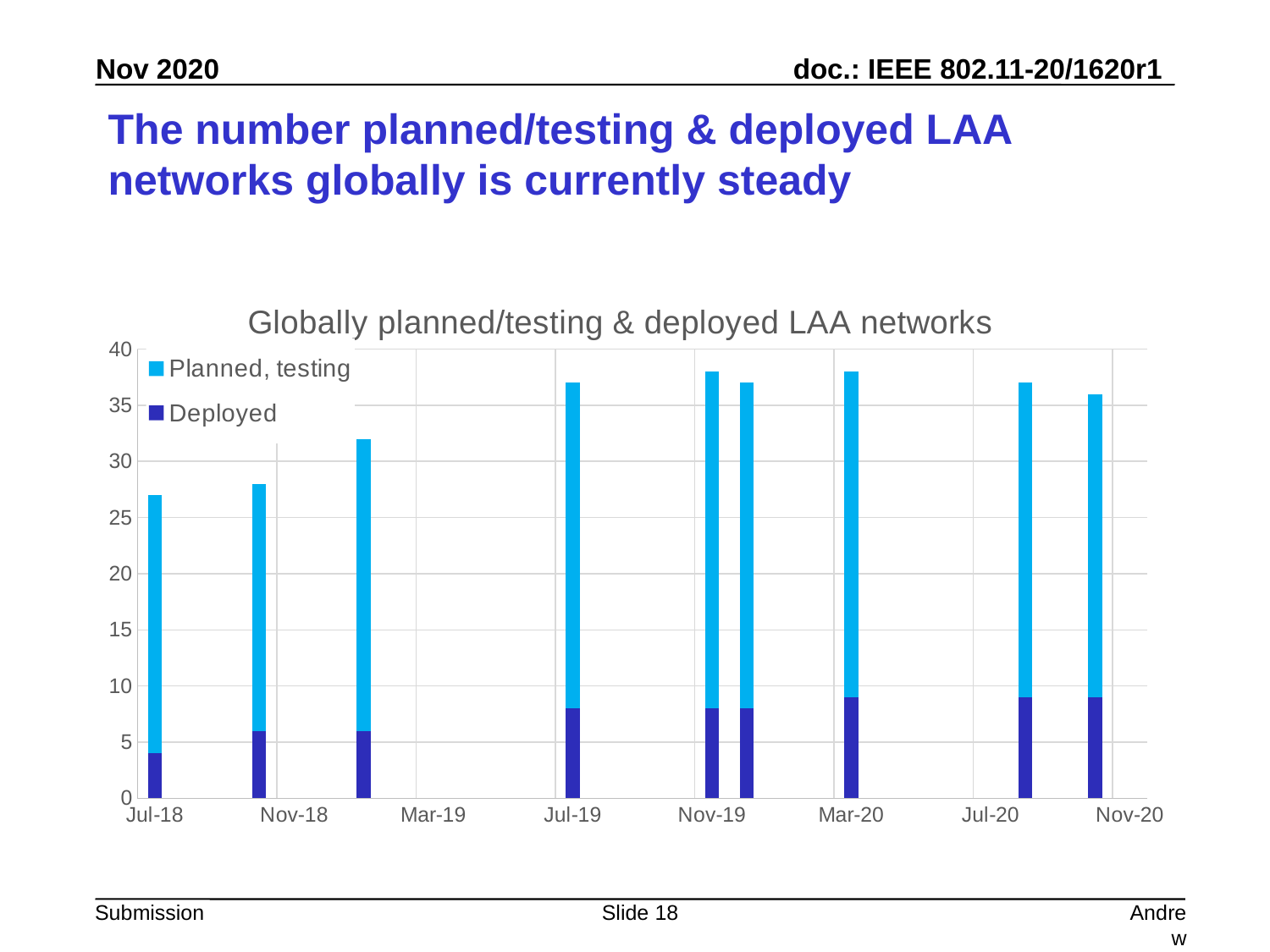
How many series does the legend list in the chart? 2 Is the Deployed value at Jul-18 greater or less than 5? less How many bars are plotted in the chart? 9 Do the total bar heights rise or fall from Jul-18 to Jul-19? rise Is the total height of the bar at Jul-18 greater or less than 30? less Is the Deployed value at Mar-20 greater or less than 5? greater What is the title of the chart? Globally planned/testing & deployed LAA networks Which series is shown in dark blue at the bottom of each bar? Deployed Which bar is taller in total, Jul-18 or Jul-19? Jul-19 What kind of chart is shown on the slide? Stacked bar chart